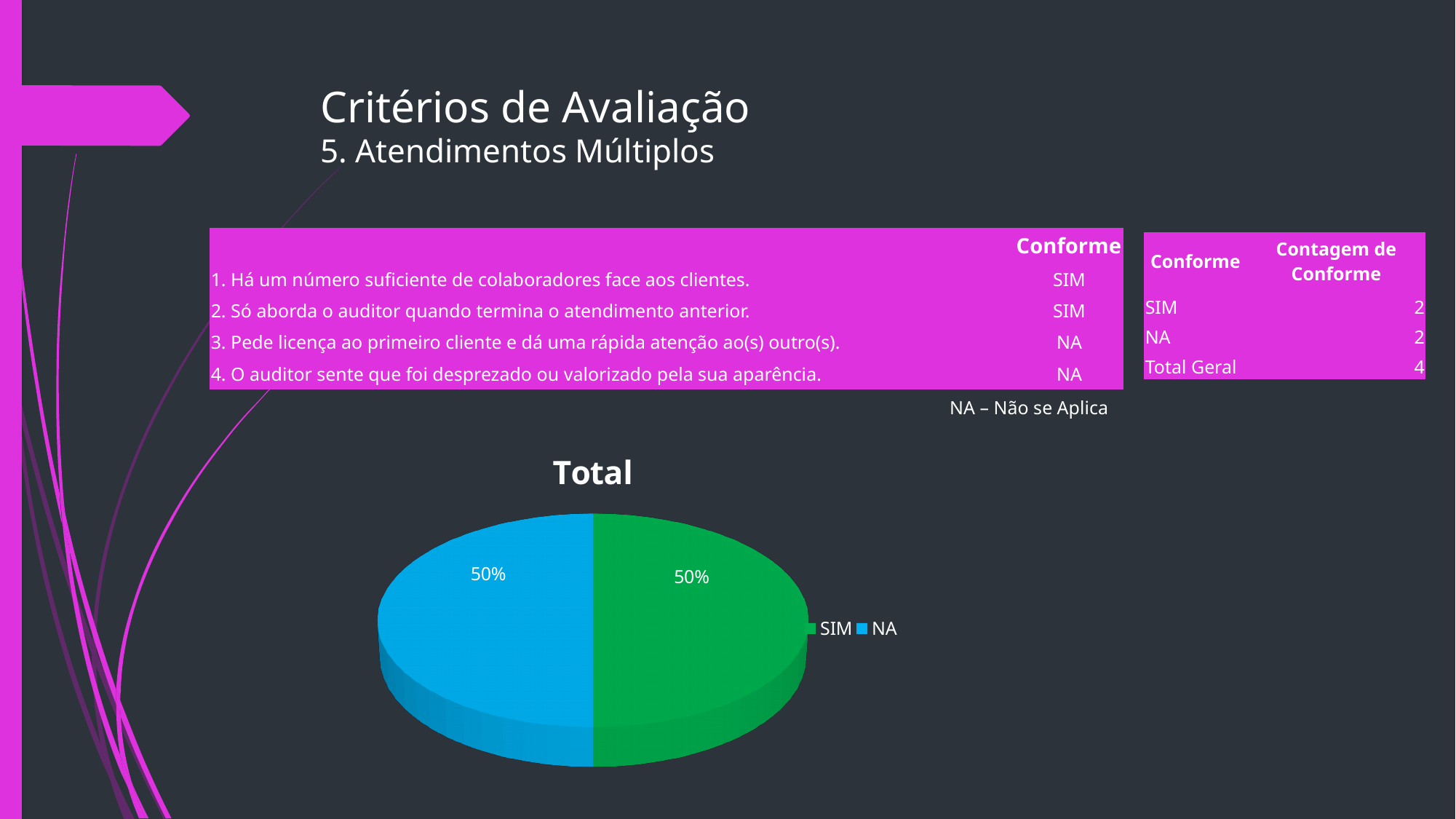
Which colour represents SIM in the pie chart? green What share of the pie does the SIM slice represent? 50% What kind of chart is shown on the slide? pie chart What is the total of the SIM and NA shares shown on the pie chart? 100% What share of the pie does the NA slice represent? 50% What is the title of the chart? Total What is the difference between the SIM share and the NA share in the pie chart? 0% How many entries does the chart legend list? 2 How many slices does the pie chart have? 2